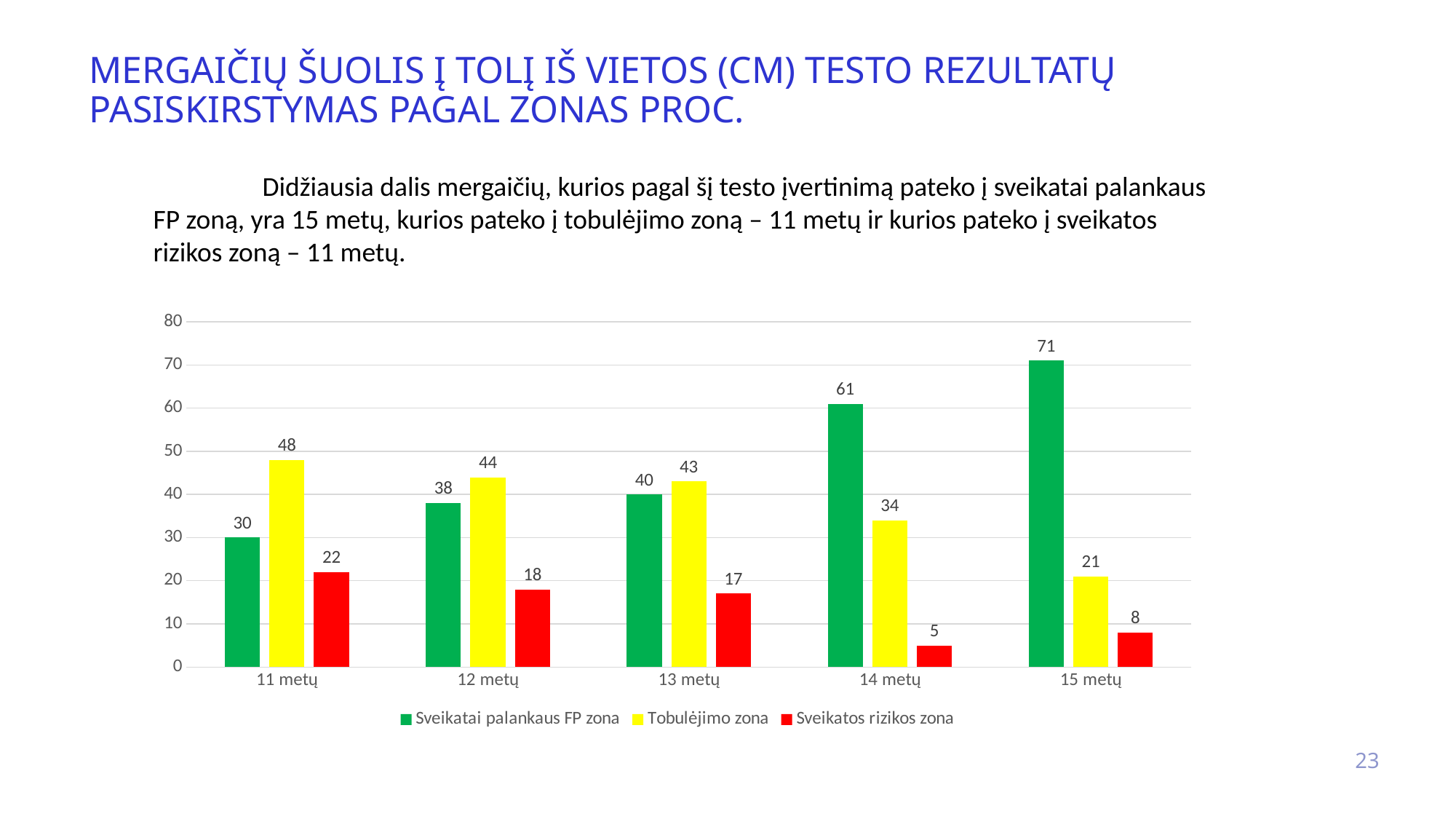
How many age groups are shown on the x axis? 5 What is the value for Sveikatai palankaus FP zona at 15 metų? 71 What is the difference between the Sveikatai palankaus FP zona values at 14 metų and 13 metų? 21 Which age group has the highest value for Sveikatai palankaus FP zona? 15 metų Which is larger at 12 metų: Sveikatai palankaus FP zona or Tobulėjimo zona? Tobulėjimo zona What is the value for Tobulėjimo zona at 11 metų? 48 What kind of chart is shown on the slide? Bar chart What is the value for Sveikatos rizikos zona at 14 metų? 5 Which age group has the lowest value for Sveikatos rizikos zona? 14 metų What colour represents Sveikatos rizikos zona in the chart? Red How many series does the legend list? 3 Do the values for Sveikatai palankaus FP zona rise or fall from 11 metų to 15 metų? Rise